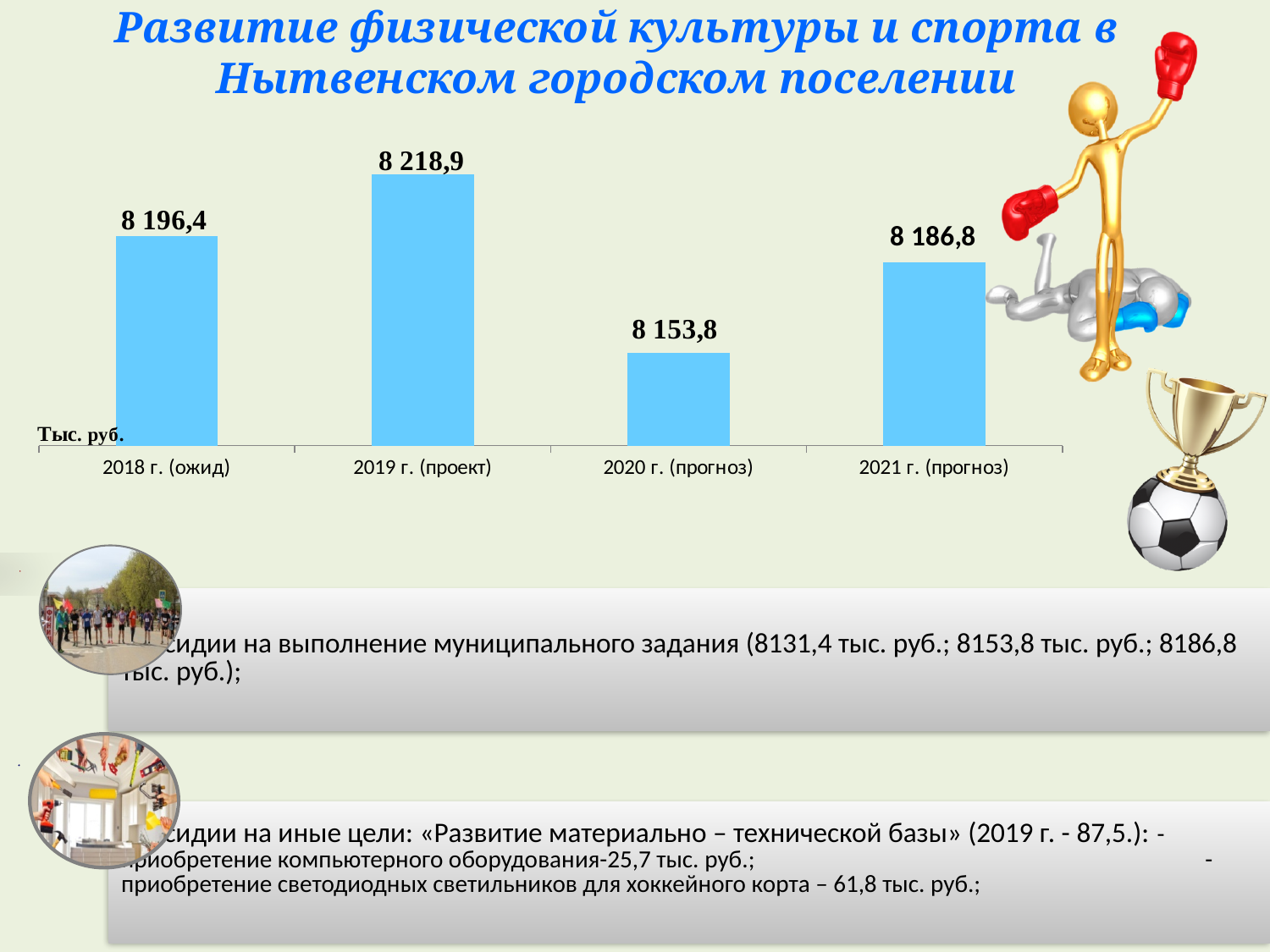
Which category has the highest value? 2019 г. (проект) How many categories are shown on the x axis? 4 What is the value for 2020 г. (прогноз)? 8 153,8 What is the value for 2021 г. (прогноз)? 8 186,8 What is the difference between the values for 2021 г. (прогноз) and 2020 г. (прогноз)? 33,0 Which category has the lowest value? 2020 г. (прогноз) What kind of chart is shown on the slide? Bar chart What is the difference between the values for 2019 г. (проект) and 2020 г. (прогноз)? 65,1 What is the value for 2019 г. (проект)? 8 218,9 What unit is indicated for the values on the chart? Тыс. руб. Which is larger, the value for 2018 г. (ожид) or the value for 2021 г. (прогноз)? 2018 г. (ожид) What is the value for 2018 г. (ожид)? 8 196,4